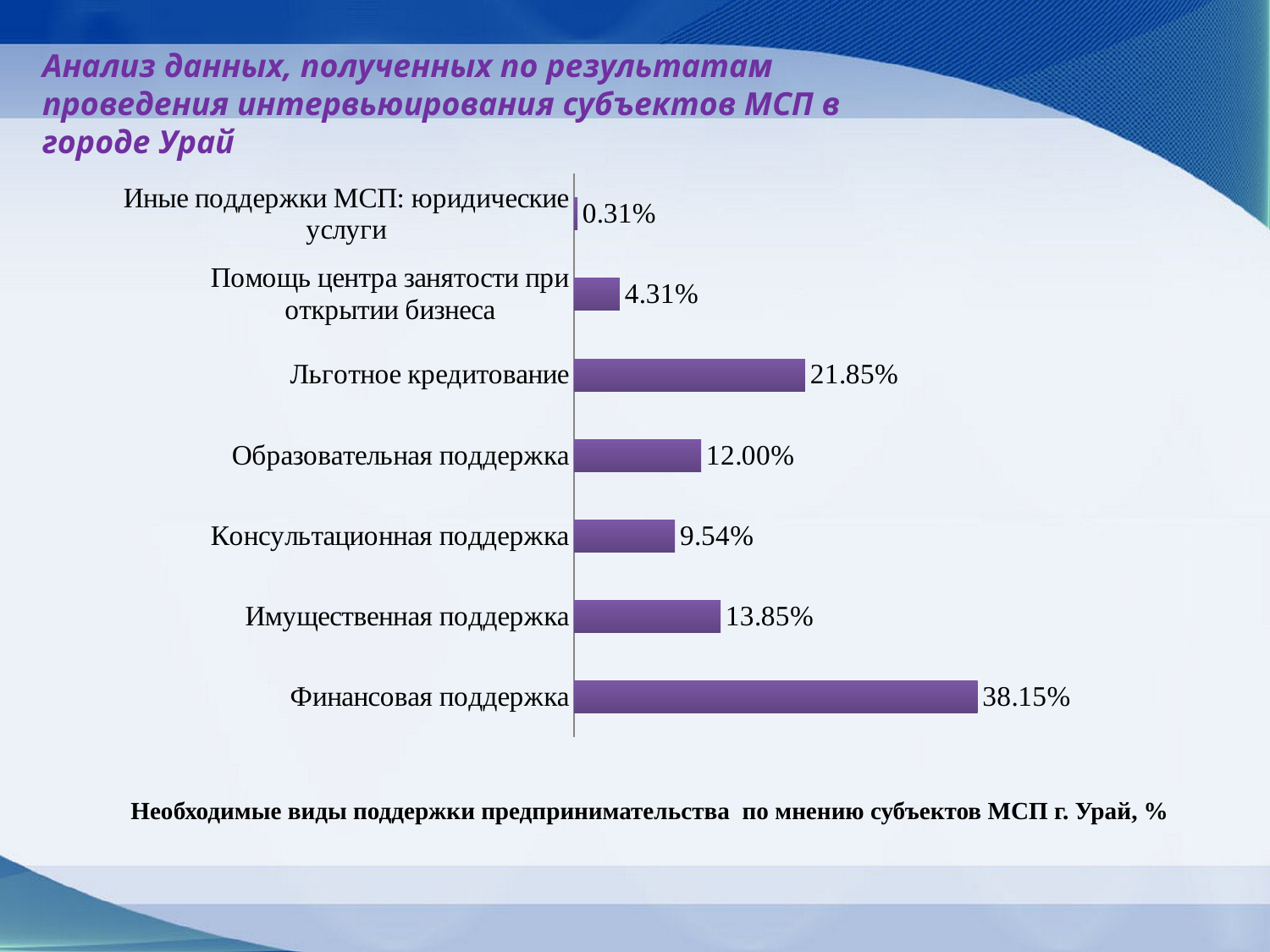
What is the value for Консультационная поддержка? 9.54% What is the caption below the chart? Необходимые виды поддержки предпринимательства по мнению субъектов МСП г. Урай, % Which is larger, Образовательная поддержка or Консультационная поддержка? Образовательная поддержка What is the difference between Имущественная поддержка and Образовательная поддержка? 1.85% What is the difference between Финансовая поддержка and Льготное кредитование? 16.30% What is the value for Помощь центра занятости при открытии бизнеса? 4.31% What is the value for Льготное кредитование? 21.85% What is the value for Финансовая поддержка? 38.15% Which category has the lowest value? Иные поддержки МСП: юридические услуги What kind of chart is shown on the slide? Bar chart Which category has the highest value? Финансовая поддержка How many categories are shown in the chart? 7